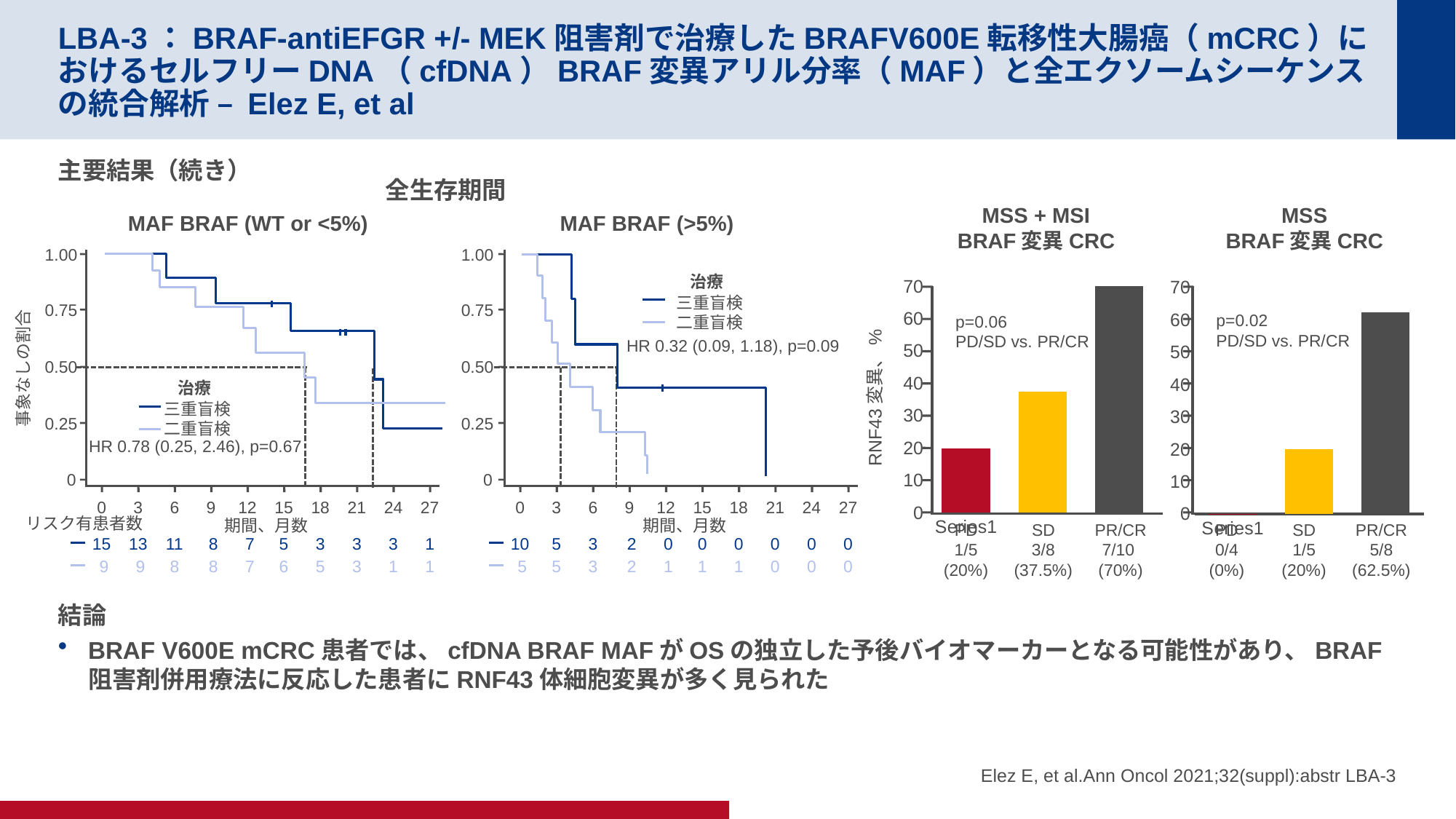
In the MSS BRAF変異CRC chart, which response category has the lowest RNF43 mutation percentage? PD In the MSS + MSI BRAF変異CRC chart, what is the difference in RNF43 mutation percentage between PR/CR and PD? 50% In the MSS + MSI BRAF変異CRC chart, what is the RNF43 mutation percentage for SD? 37.5% In the MSS + MSI BRAF変異CRC chart, which response category has the highest RNF43 mutation percentage? PR/CR In the MAF BRAF (>5%) survival chart, what hazard ratio is reported? HR 0.32 (0.09, 1.18), p=0.09 In the MSS BRAF変異CRC chart, is the RNF43 mutation percentage for SD larger or smaller than for PR/CR? smaller How many response categories are shown in the MSS BRAF変異CRC bar chart? 3 In the MSS BRAF変異CRC chart, what is the RNF43 mutation percentage for PR/CR? 62.5% In the MSS + MSI BRAF変異CRC chart, what is the RNF43 mutation percentage for PR/CR? 70% In the MAF BRAF (WT or <5%) survival chart, how many 三重盲検 patients are at risk at month 0? 15 In the MSS BRAF変異CRC chart, what is the difference in RNF43 mutation percentage between PR/CR and SD? 42.5% What kind of chart is the MSS + MSI BRAF変異CRC chart? bar chart